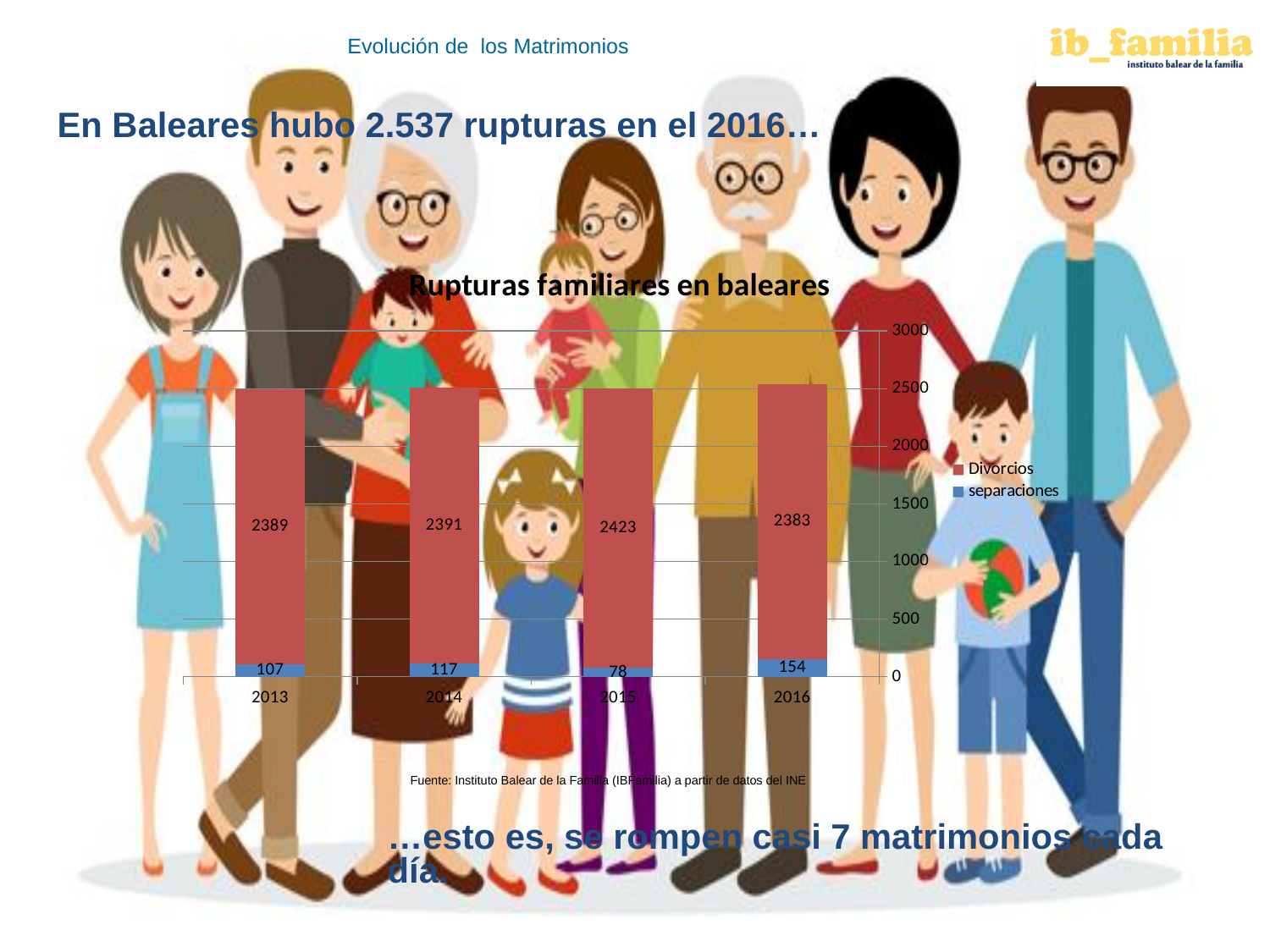
What kind of chart is shown? Stacked bar chart Which year has the lowest value for separaciones? 2015 Which year has the highest value for separaciones? 2016 What is the difference between the separaciones values for 2016 and 2015? 76 What is the value for Divorcios in 2013? 2389 Which is larger, the Divorcios value for 2015 or for 2016? 2015 Which year has the highest value for Divorcios? 2015 How many series does the legend list? 2 What is the value for Divorcios in 2015? 2423 What is the total of the stacked bar for 2016? 2537 How many years are shown on the x axis? 4 What is the value for separaciones in 2016? 154